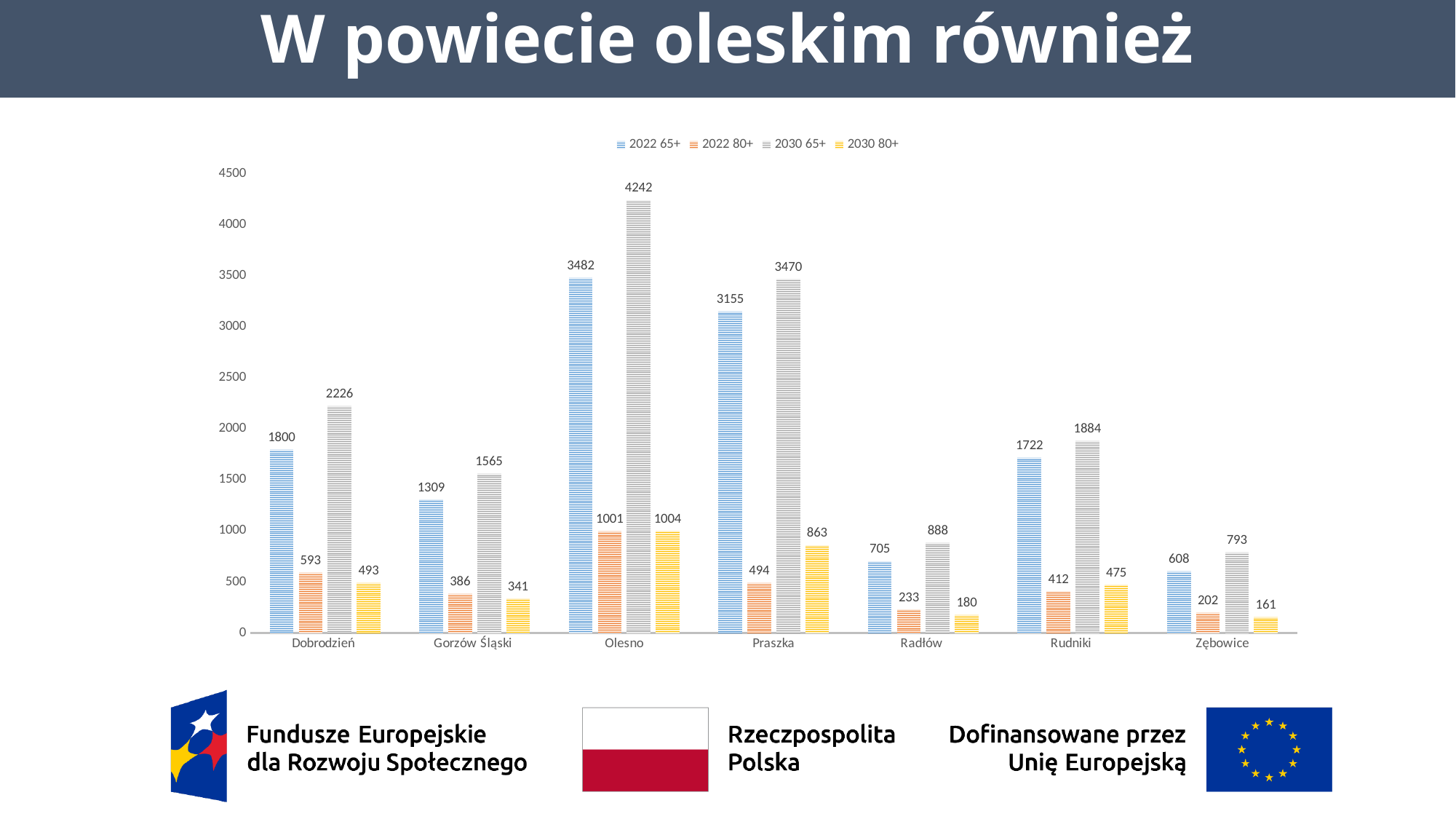
Which category has the highest value for 2022 65+? Olesno Is the value for 2022 65+ in Praszka greater or less than 3000? greater What is the value for 2030 65+ in Olesno? 4242 What is the title of the slide? W powiecie oleskim również Which is larger: the 2022 80+ value for Olesno or the 2030 80+ value for Olesno? 2030 80+ (1004) Which category has the lowest value for 2030 80+? Zębowice How many categories are shown on the x axis? 7 How many series does the legend list? 4 What is the difference between the 2030 65+ and 2022 65+ values for Dobrodzień? 426 What is the value for 2030 80+ in Praszka? 863 What kind of chart is shown on the slide? Bar chart What is the value for 2022 80+ in Rudniki? 412